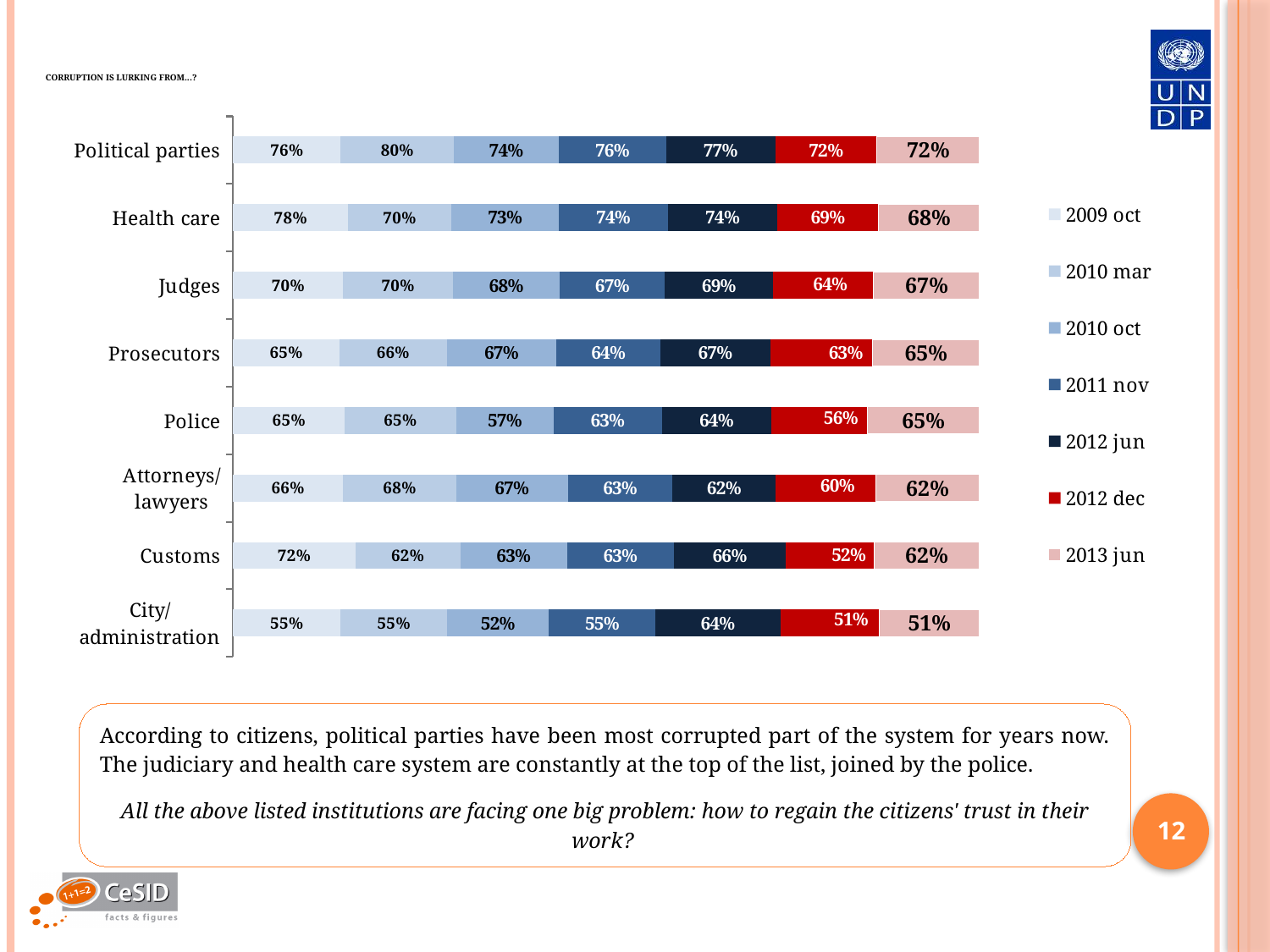
What kind of chart is shown on the slide? Stacked bar chart How many categories are shown on the chart? 8 What is the value for Political parties in 2010 mar? 80% What is the value for Health care in 2013 jun? 68% What is the value for Customs in 2012 dec? 52% Which category has the lowest value in 2013 jun? City/administration Which is larger, the Judges value in 2011 nov or the Prosecutors value in 2011 nov? Judges Which legend entry is shown in red? 2012 dec What is the value for City/administration in 2012 jun? 64% How many series does the legend list? 7 What is the difference between the Political parties and Police values in 2012 dec? 16% Which category has the highest value in 2009 oct? Health care